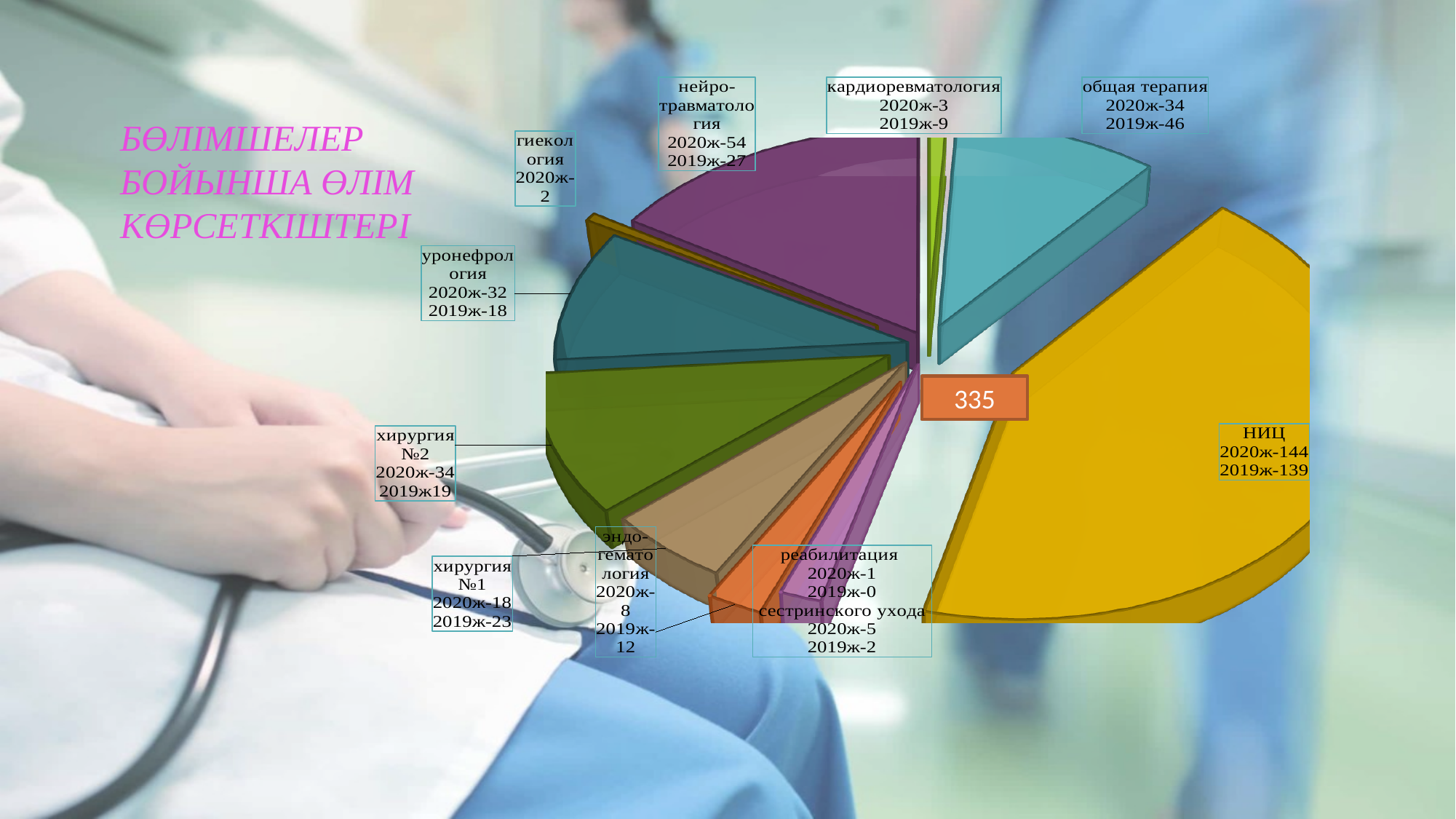
What is the difference between the 2020 and 2019 values for нейро-травматология? 27 Which is larger, the 2020 value for уронефрология or the 2020 value for хирургия №1? уронефрология What number is shown in the box at the centre of the pie chart? 335 How many departments are labelled on the pie chart? 11 What is the 2020 value for НИЦ? 144 What is the 2020 value for нейро-травматология? 54 What is the 2019 value for хирургия №1? 23 Which department has the largest slice of the pie? НИЦ What is the difference between the 2020 and 2019 values for НИЦ? 5 Which department has the lowest 2020 value? реабилитация What kind of chart is shown on the slide? pie chart What is the 2019 value for общая терапия? 46